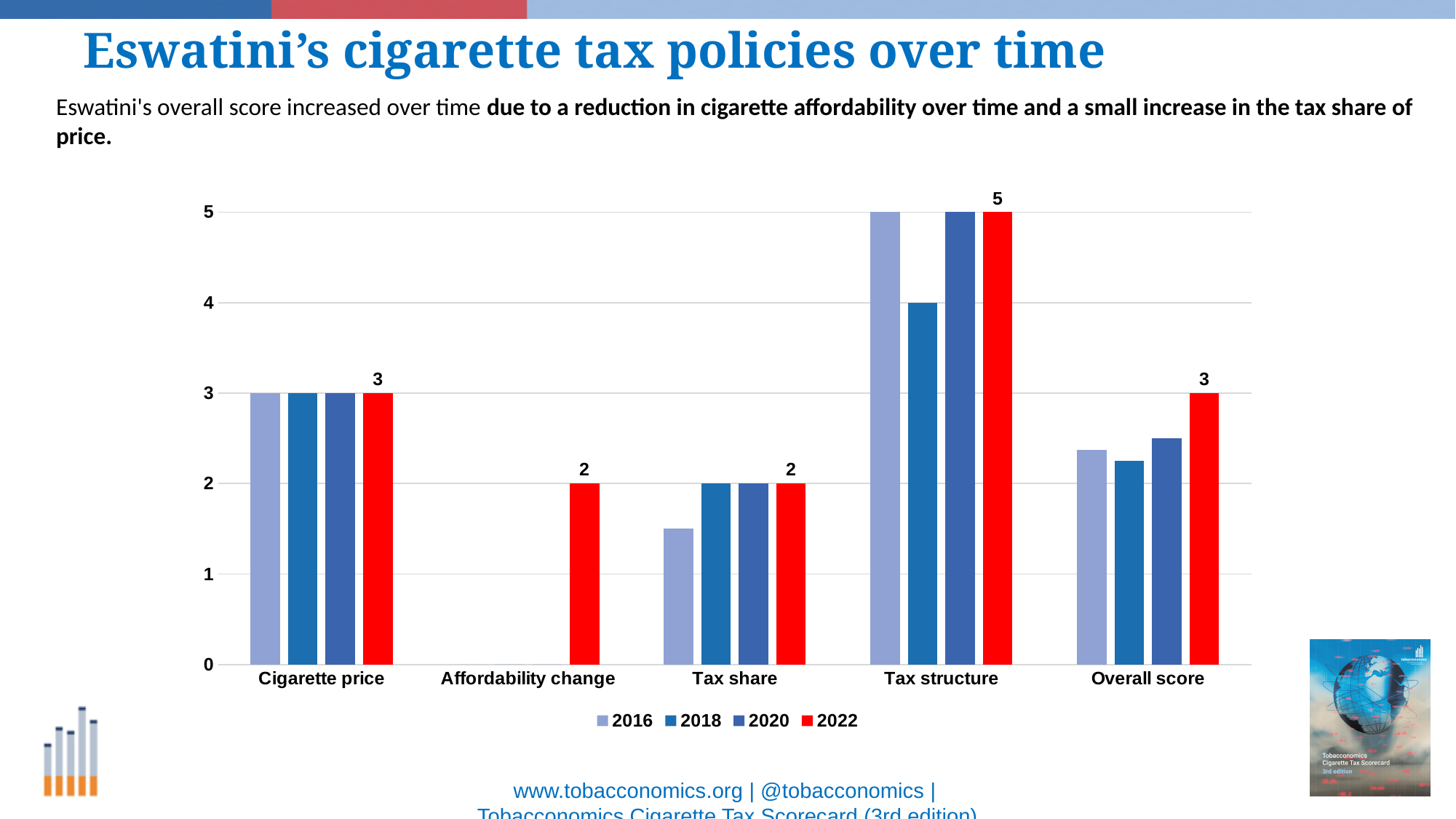
What is the value for Tax structure in 2018? 4 How many categories are shown on the x axis? 5 Is the value for Overall score in 2016 greater or less than 2? greater For Tax structure, which year has the lowest value? 2018 Is the value for Tax share in 2016 greater or less than 2? less How many series does the legend list? 4 What is the value for Affordability change in 2022? 2 What is the difference between the 2022 values for Tax structure and Overall score? 2 Which category has the highest value for 2022? Tax structure What is the value for Tax structure in 2022? 5 Which is larger in 2022: Cigarette price or Tax share? Cigarette price What is the value for Overall score in 2022? 3